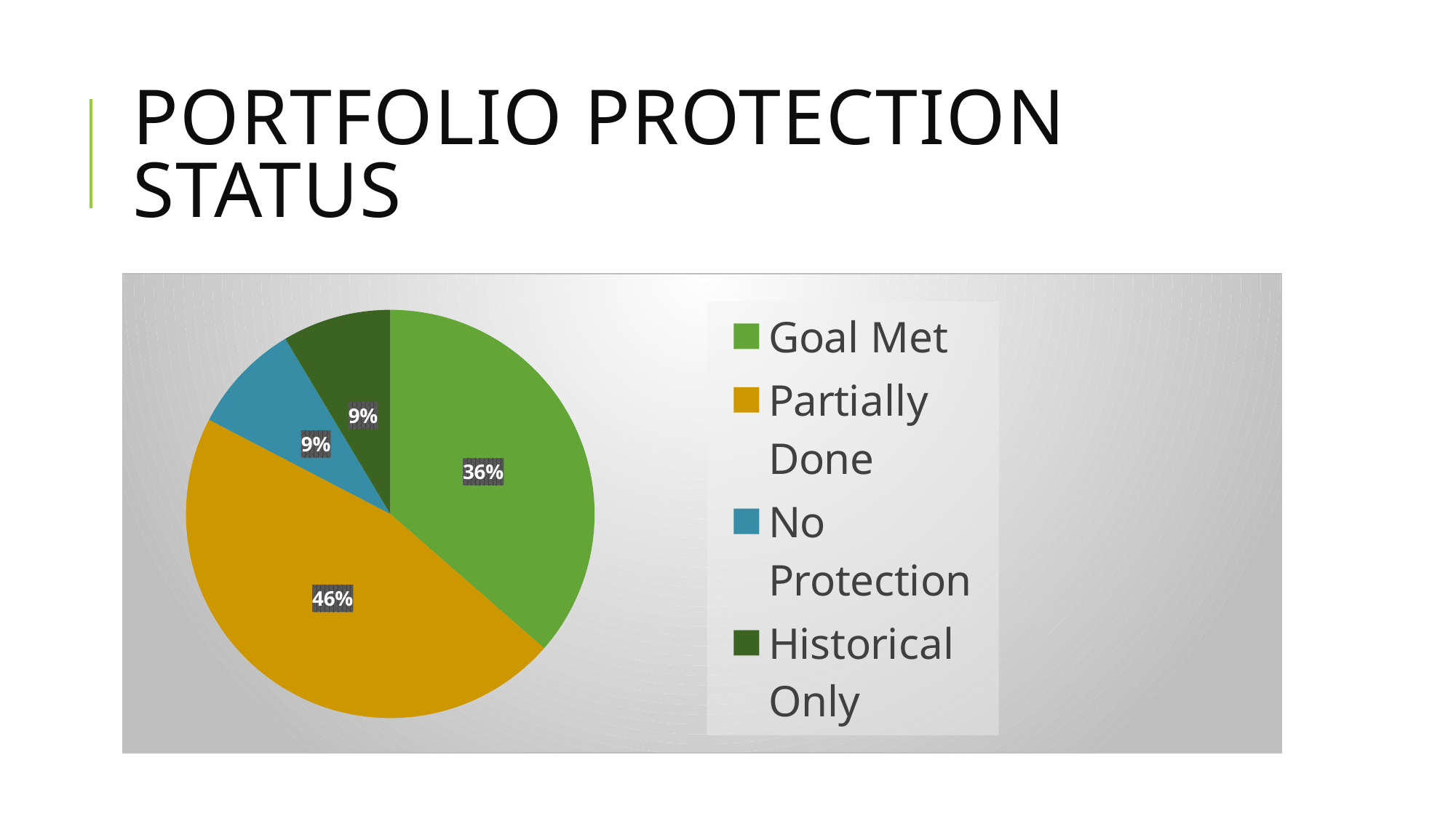
Which category has the largest slice of the pie? Partially Done What is the difference in percentage points between Partially Done and Goal Met? 10 What share of the pie does No Protection represent? 9% What share of the pie does Goal Met represent? 36% What share of the pie does Partially Done represent? 46% Which is larger, the Goal Met slice or the No Protection slice? Goal Met What kind of chart is shown on the slide? Pie chart Which category is shown in the dark green colour in the legend? Historical Only What is the title of the slide containing the chart? Portfolio Protection Status How many categories does the pie chart show? 4 What is the combined share of Goal Met and Partially Done? 82%